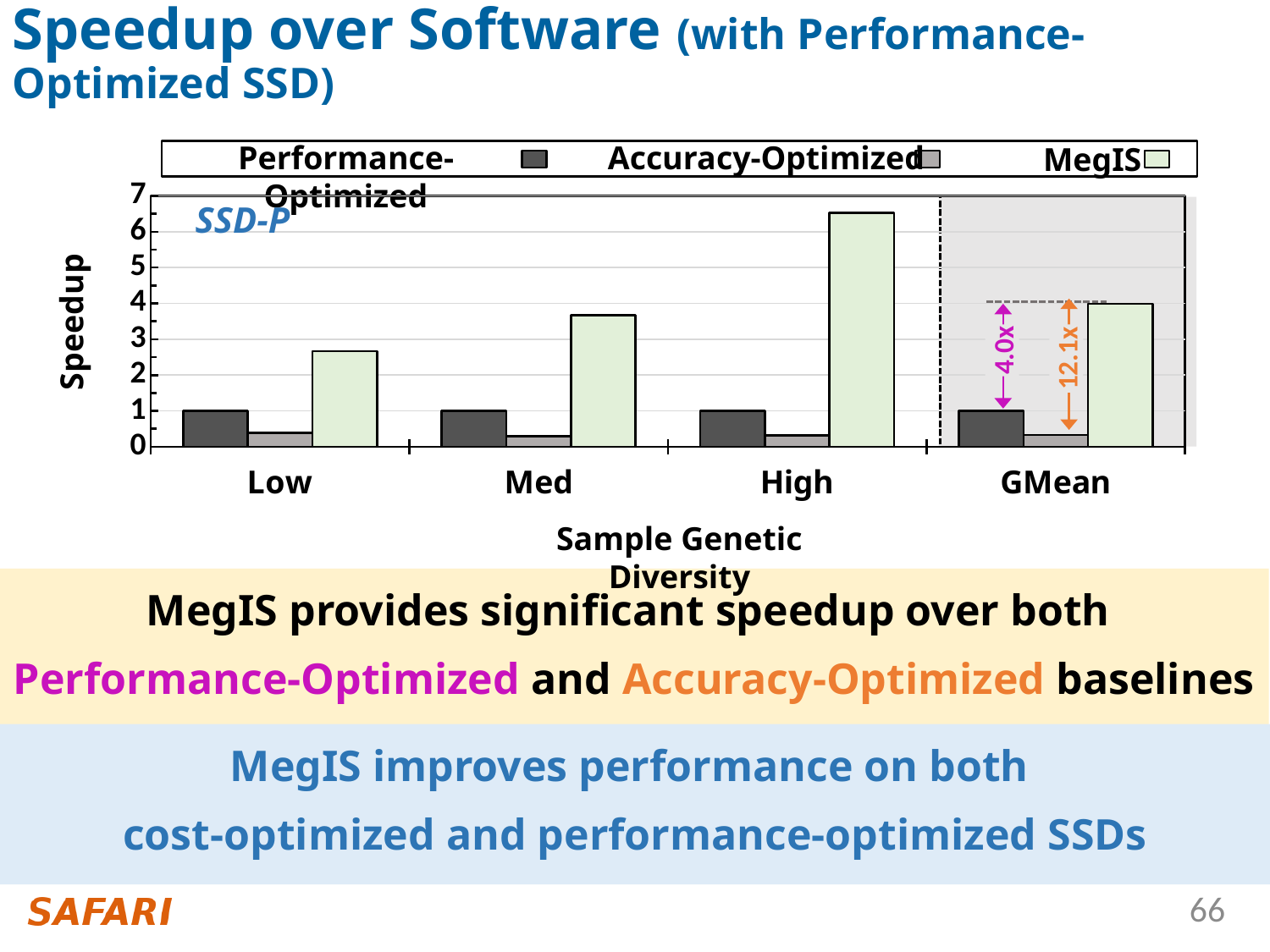
What speedup does the annotation show for MegIS over Accuracy-Optimized at GMean? 12.1x Is the MegIS value for Low greater or less than 3? less What speedup does the annotation show for MegIS over Performance-Optimized at GMean? 4.0x What is the speedup value for Performance-Optimized at Low? 1 How many series does the legend list? 3 Do the MegIS values rise or fall from Low to High? rise For which category is the MegIS bar lowest? Low For which category is the MegIS bar highest? High How many categories are shown on the x axis? 4 Which is larger, the MegIS value for Med or the MegIS value for High? High What kind of chart is shown on the slide? bar chart Is the MegIS value for High greater or less than 6? greater